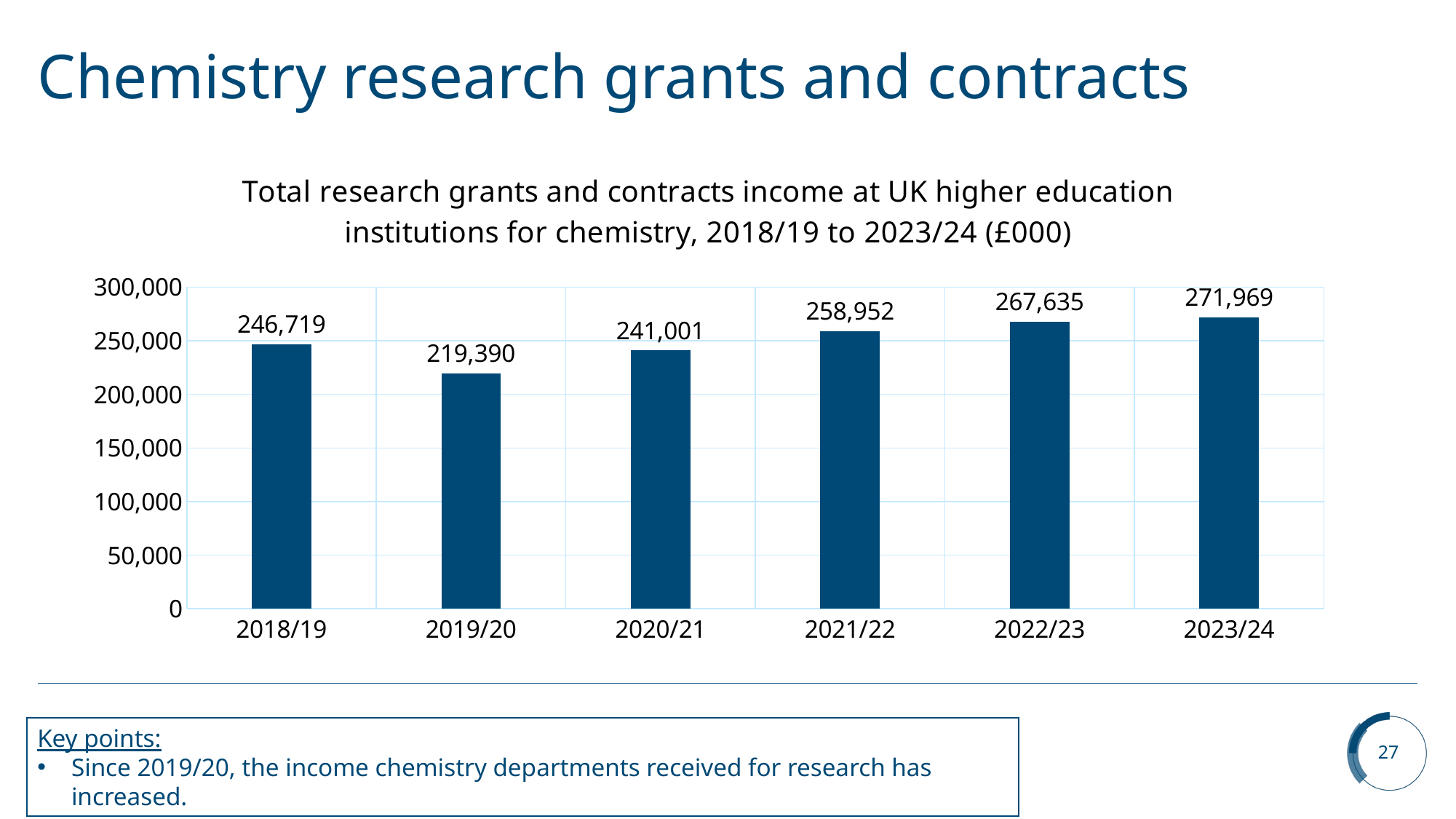
What is the total research grants and contracts income for chemistry in 2018/19? 246,719 What is the difference between the values for 2023/24 and 2022/23? 4,334 How many academic years are shown on the x axis? 6 Which year has the lowest research grants and contracts income? 2019/20 Which is larger, the value for 2018/19 or the value for 2020/21? 2018/19 What kind of chart is shown on the slide? Bar chart What is the value shown for 2019/20? 219,390 Is the value for 2021/22 greater or less than 250,000? greater Which year has the highest research grants and contracts income? 2023/24 What is the difference between the values for 2018/19 and 2019/20? 27,329 Do the values rise or fall from 2019/20 to 2023/24? Rise What is the value shown for 2023/24? 271,969